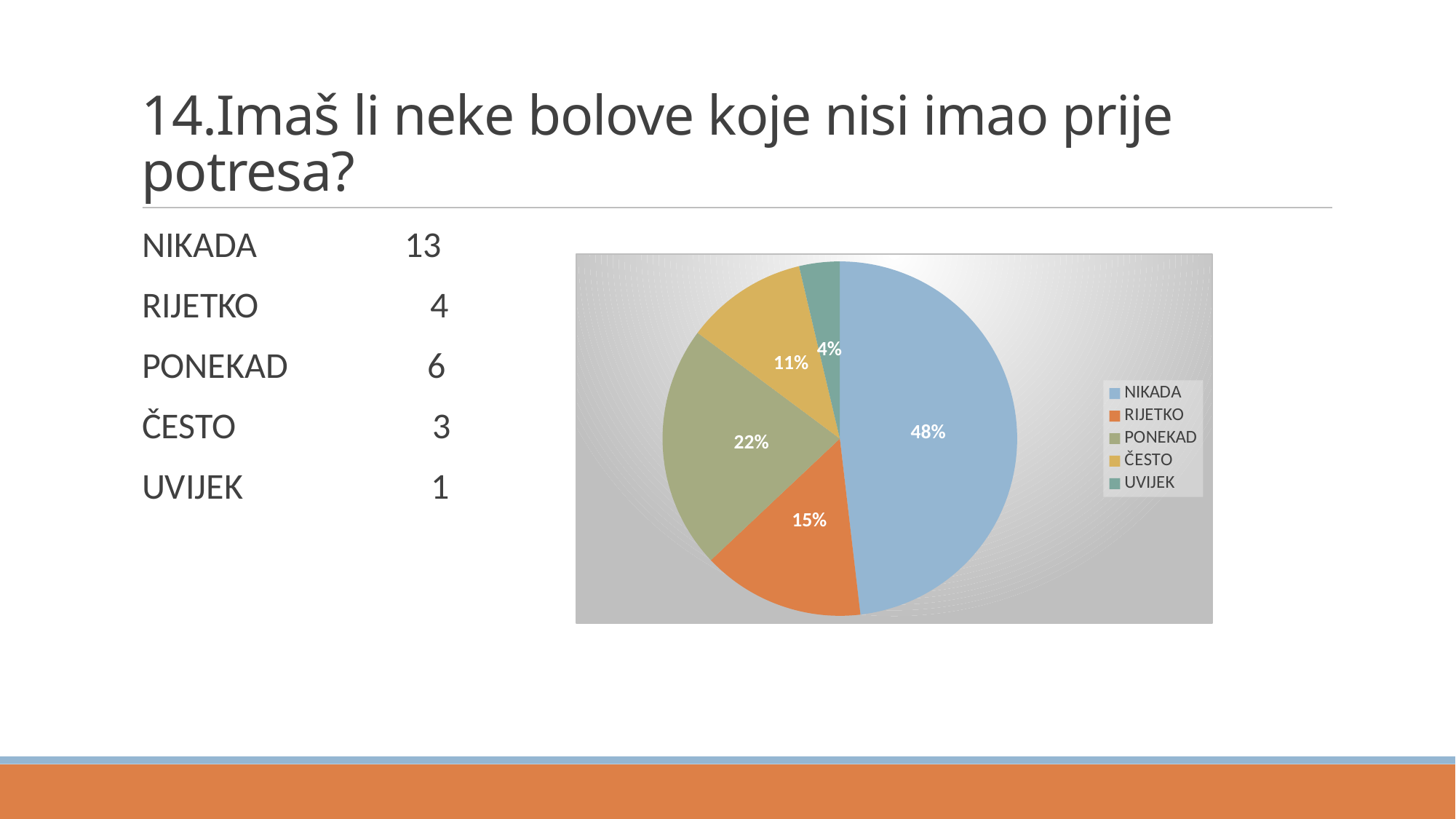
What percentage share does the ČESTO slice have in the pie chart? 11% Which category has the largest slice in the pie chart? NIKADA What colour is the NIKADA slice in the pie chart? blue What percentage share does the RIJETKO slice have in the pie chart? 15% How many slices does the pie chart have? 5 What is the difference in percentage points between the NIKADA and PONEKAD slices? 26% What percentage share does the UVIJEK slice have in the pie chart? 4% Which slice is larger in the pie chart, PONEKAD or RIJETKO? PONEKAD What kind of chart is shown on the slide? pie chart Which category has the smallest slice in the pie chart? UVIJEK